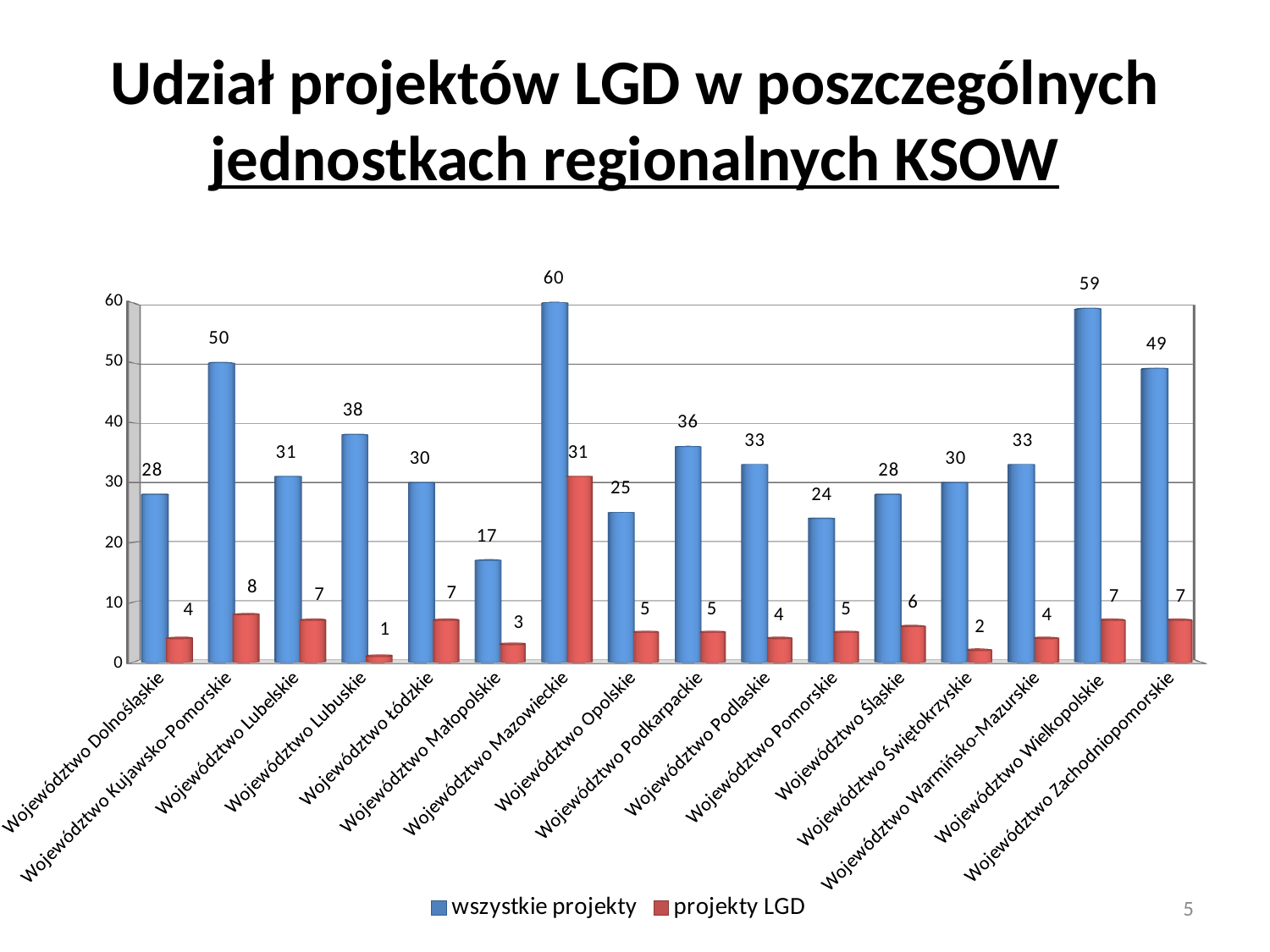
Is the value of 'wszystkie projekty' for Województwo Zachodniopomorskie greater or less than 40? greater What is the difference between 'wszystkie projekty' and 'projekty LGD' for Województwo Wielkopolskie? 52 How many series does the legend list? 2 What is the value of 'wszystkie projekty' for Województwo Kujawsko-Pomorskie? 50 How many voivodeships are shown on the x axis? 16 Which series is shown in red? projekty LGD What is the value of 'projekty LGD' for Województwo Mazowieckie? 31 Which voivodeship has the lowest value for 'wszystkie projekty'? Województwo Małopolskie Which voivodeship has the lowest value for 'projekty LGD'? Województwo Lubuskie What kind of chart is shown on the slide? bar chart Which voivodeship has the highest value for 'wszystkie projekty'? Województwo Mazowieckie Which is larger: 'wszystkie projekty' for Województwo Lubuskie or for Województwo Podkarpackie? Województwo Lubuskie